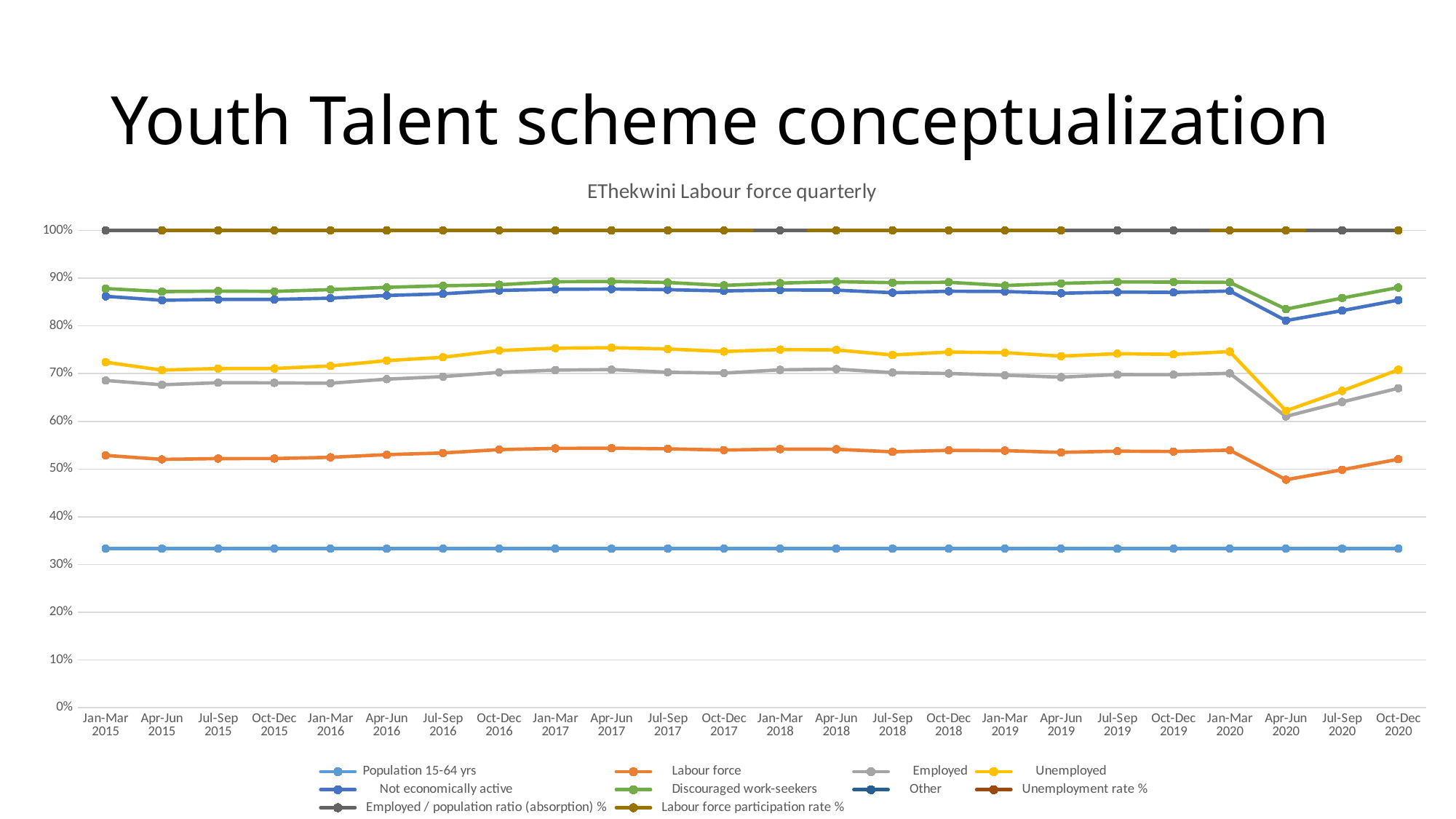
How many quarters are plotted along the x axis? 24 What is the title of the chart? EThekwini Labour force quarterly In which quarter is the Labour force series at its lowest? Apr-Jun 2020 What kind of chart is shown on the slide? Line chart Is the value for Unemployed in Jan-Mar 2017 greater or less than 70%? greater Is the value for Labour force in Apr-Jun 2020 greater or less than 50%? less Does the Labour force series rise or fall from Jan-Mar 2020 to Apr-Jun 2020? Fall Is the value for Employed in Oct-Dec 2020 greater or less than 70%? less How many series does the legend list? 10